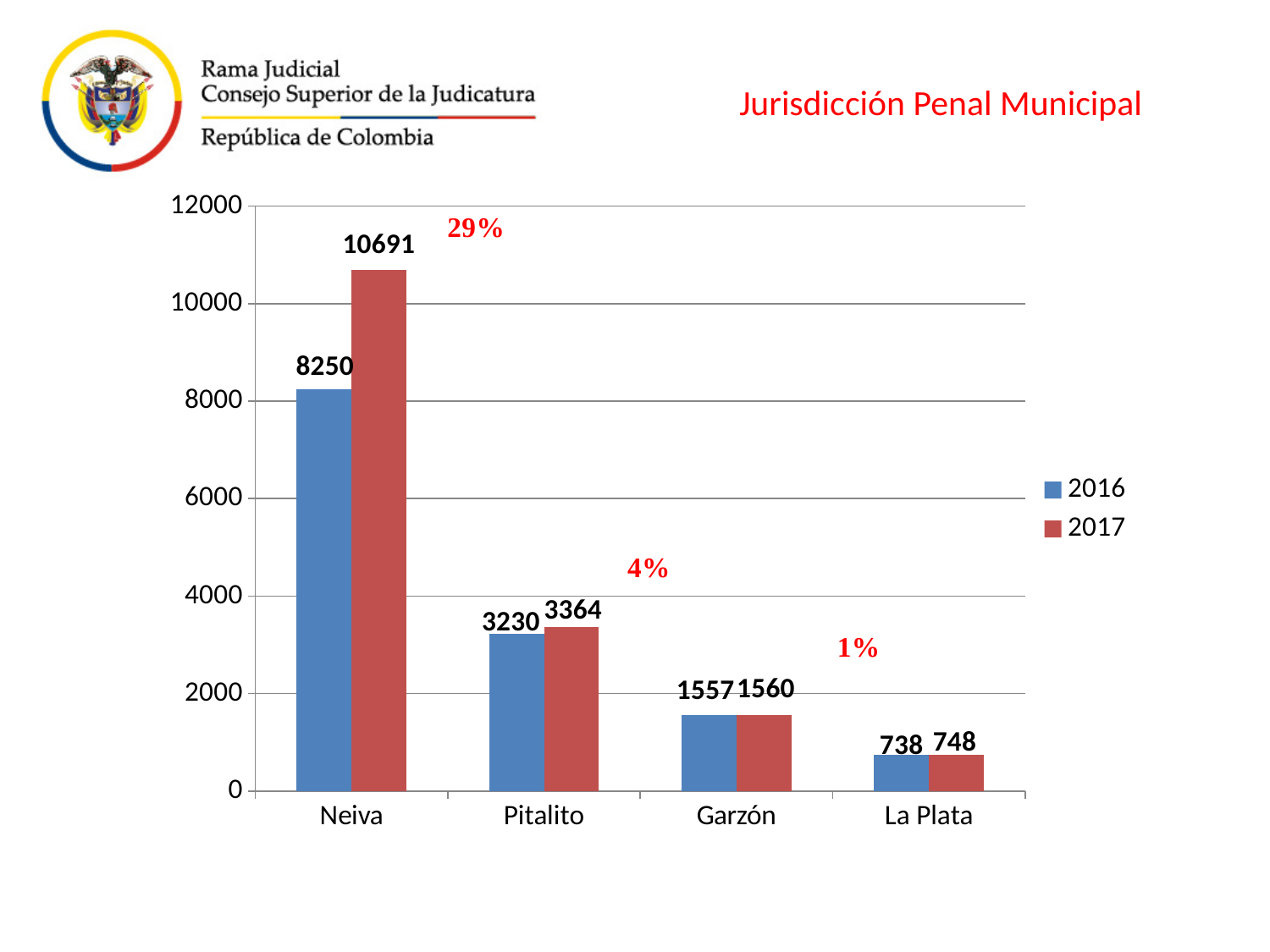
How many categories are shown on the x axis? 4 Which is larger for Neiva, the 2016 value or the 2017 value? 2017 What is the value for Neiva in 2017? 10691 What is the difference between the 2017 and 2016 values for Pitalito? 134 What is the value for La Plata in 2017? 748 Which category has the lowest value in 2016? La Plata What is the value for Garzón in 2016? 1557 Which category has the highest value in 2017? Neiva What is the difference between the 2017 and 2016 values for Neiva? 2441 How many series does the legend list? 2 What is the value for Pitalito in 2016? 3230 What kind of chart is shown on the slide? Bar chart